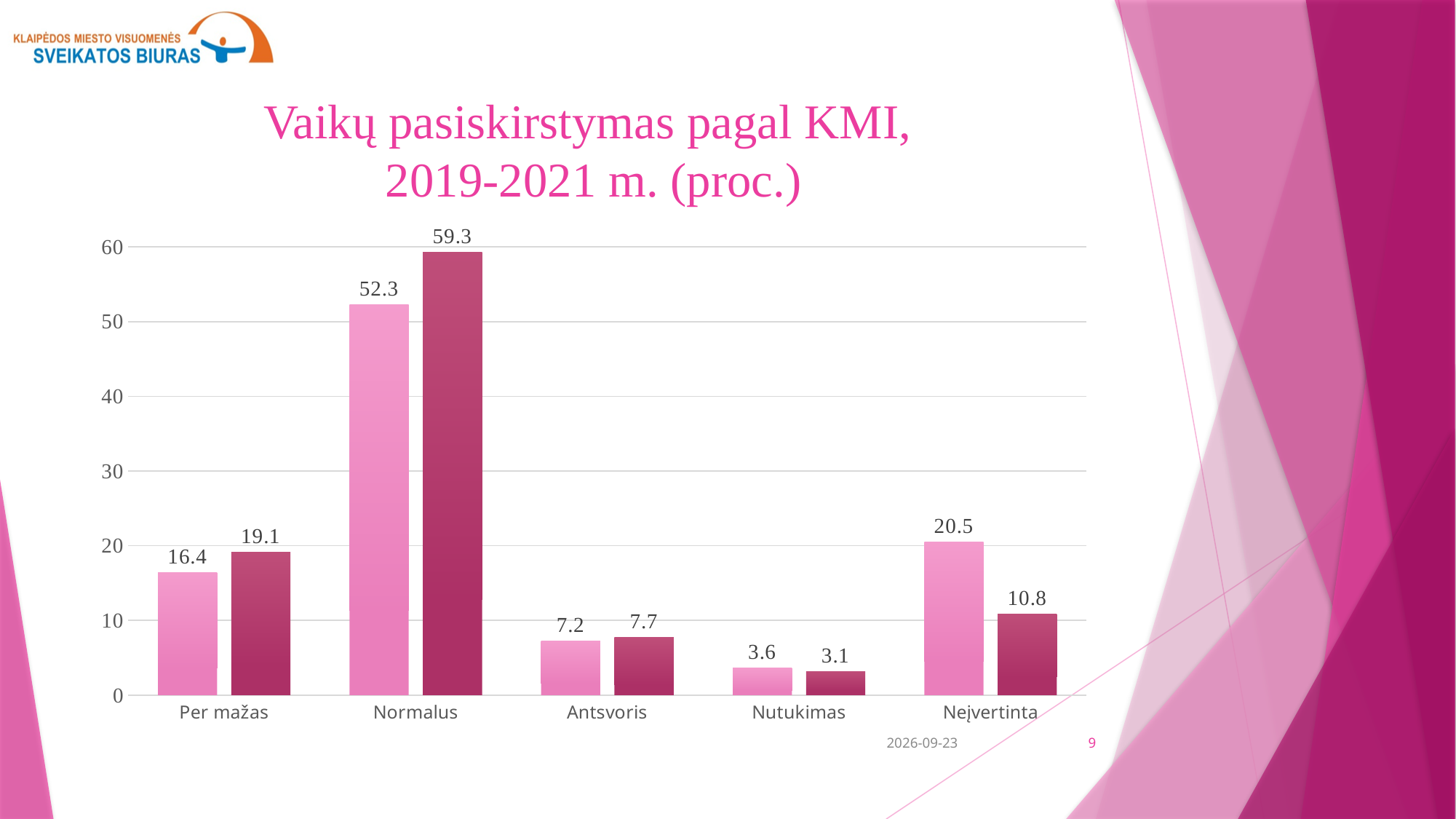
Which is larger for Antsvoris, the light pink bar or the dark pink bar? the dark pink bar What is the title of the chart? Vaikų pasiskirstymas pagal KMI, 2019-2021 m. (proc.) What is the value of the light pink bar for Normalus? 52.3 Which category has the lowest value in the chart? Nutukimas What is the difference between the light pink and dark pink bars for Neįvertinta? 9.7 What is the difference between the dark pink and light pink bars for Per mažas? 2.7 What type of chart is shown on the slide? bar chart What is the value of the light pink bar for Nutukimas? 3.6 What is the value of the dark pink bar for Normalus? 59.3 How many categories are shown on the x axis of the chart? 5 Which category has the highest value in the chart? Normalus What is the value of the dark pink bar for Neįvertinta? 10.8